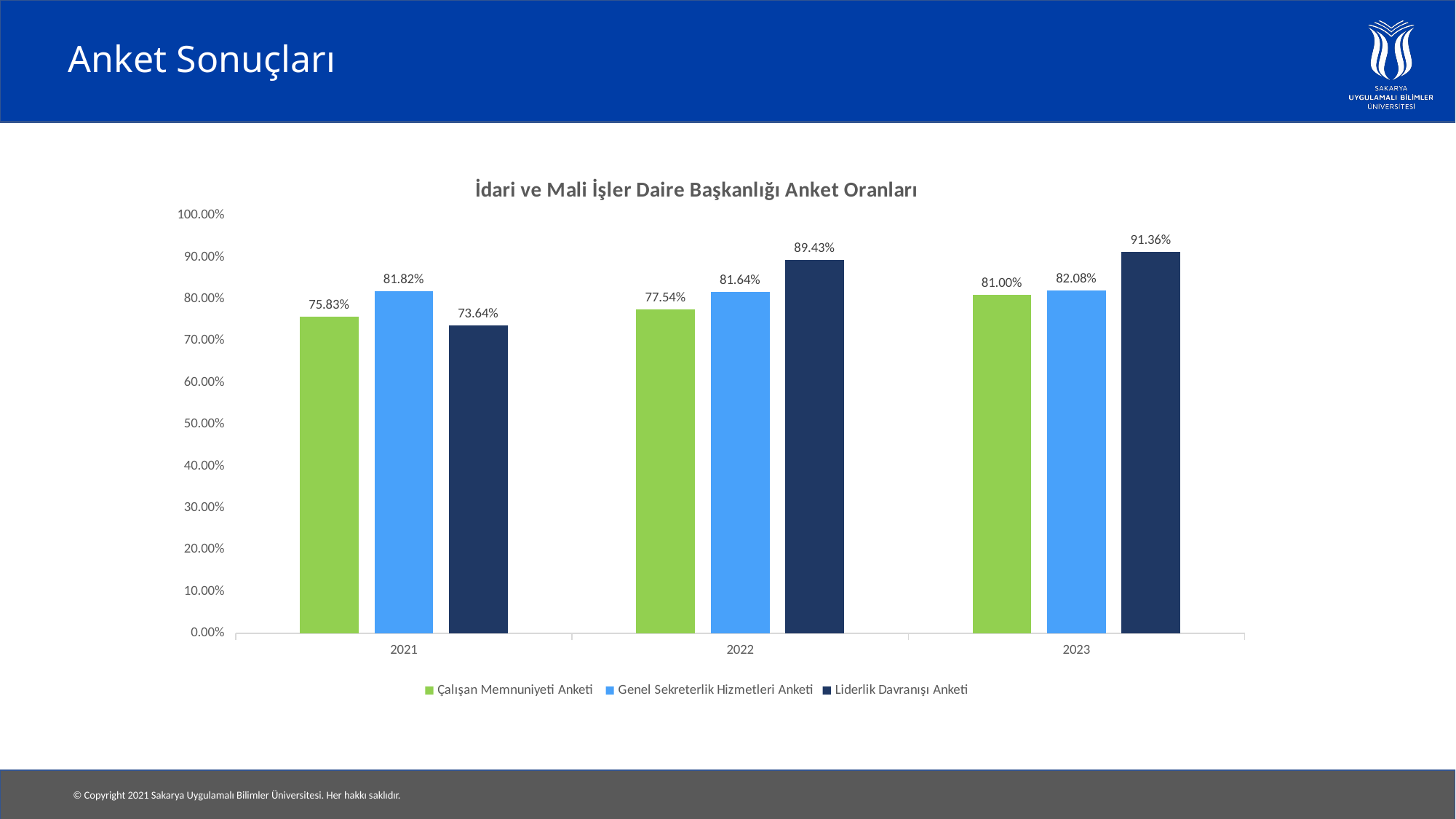
What is the value of Liderlik Davranışı Anketi for 2023? 91.36% How many series does the legend list? 3 What is the value of Genel Sekreterlik Hizmetleri Anketi for 2022? 81.64% Does the Çalışan Memnuniyeti Anketi value rise or fall from 2021 to 2023? Rise Which is larger in 2022: Çalışan Memnuniyeti Anketi or Genel Sekreterlik Hizmetleri Anketi? Genel Sekreterlik Hizmetleri Anketi What is the difference between the Liderlik Davranışı Anketi values for 2023 and 2021? 17.72% What is the value of Çalışan Memnuniyeti Anketi for 2021? 75.83% What kind of chart is shown on the slide? Bar chart Which year has the highest value for Liderlik Davranışı Anketi? 2023 How many years are shown on the x axis? 3 Is the value for Liderlik Davranışı Anketi in 2022 greater or less than 80.00%? greater Which series has the lowest value in 2021? Liderlik Davranışı Anketi